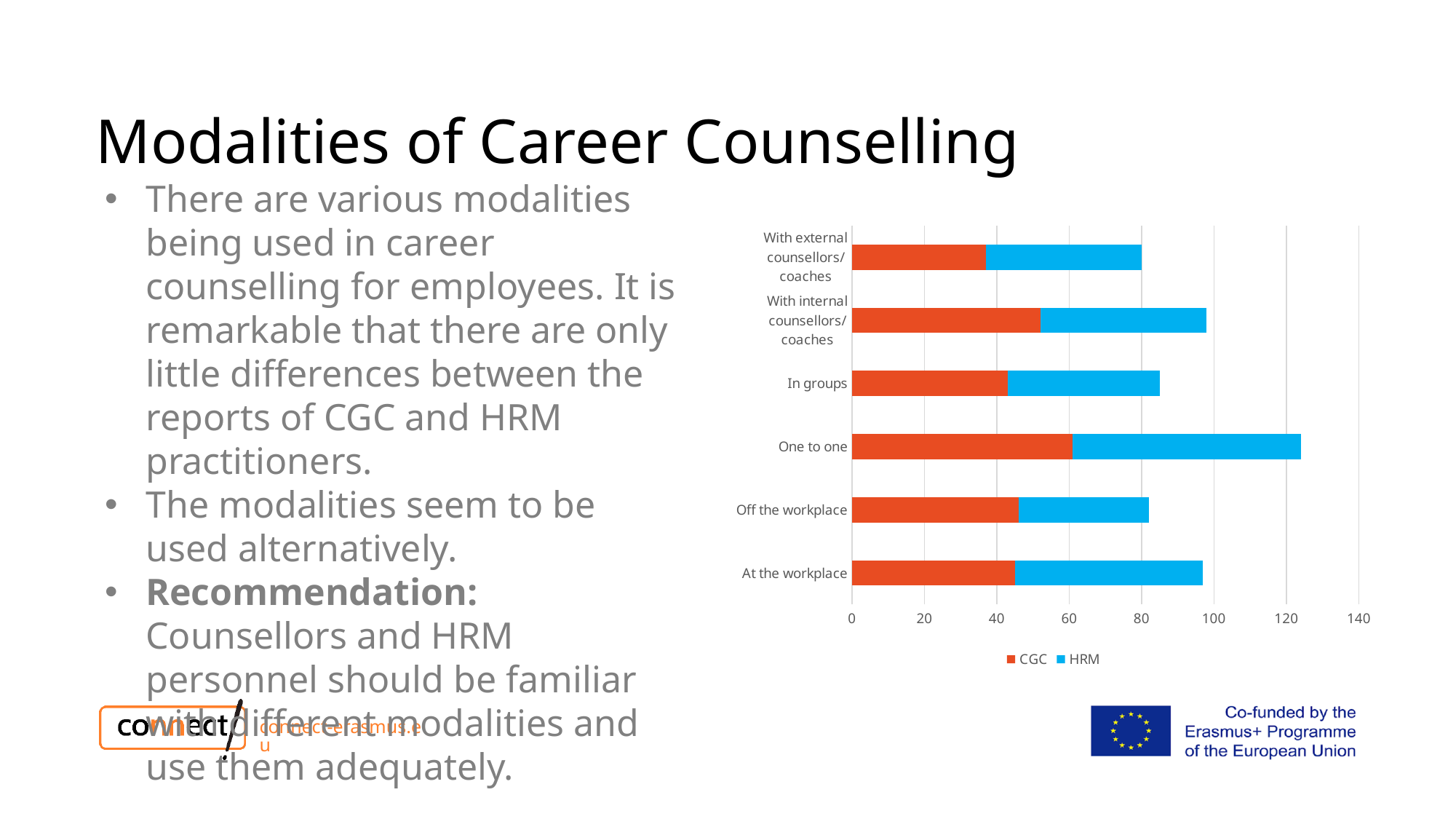
Which is larger, the total bar for One to one or the total bar for At the workplace? One to one How many series does the legend list? 2 Is the total bar for With external counsellors/coaches greater or less than 100? less Which is larger, the CGC value for With internal counsellors/coaches or the CGC value for With external counsellors/coaches? With internal counsellors/coaches Is the total bar for One to one greater or less than 120? greater How many categories are shown on the chart? 6 What kind of chart is shown on the slide? Stacked bar chart Is the CGC value for With internal counsellors/coaches greater or less than 40? greater Which category has the longest total bar? One to one Which series is shown in blue in the legend? HRM Which category has the largest CGC value? One to one